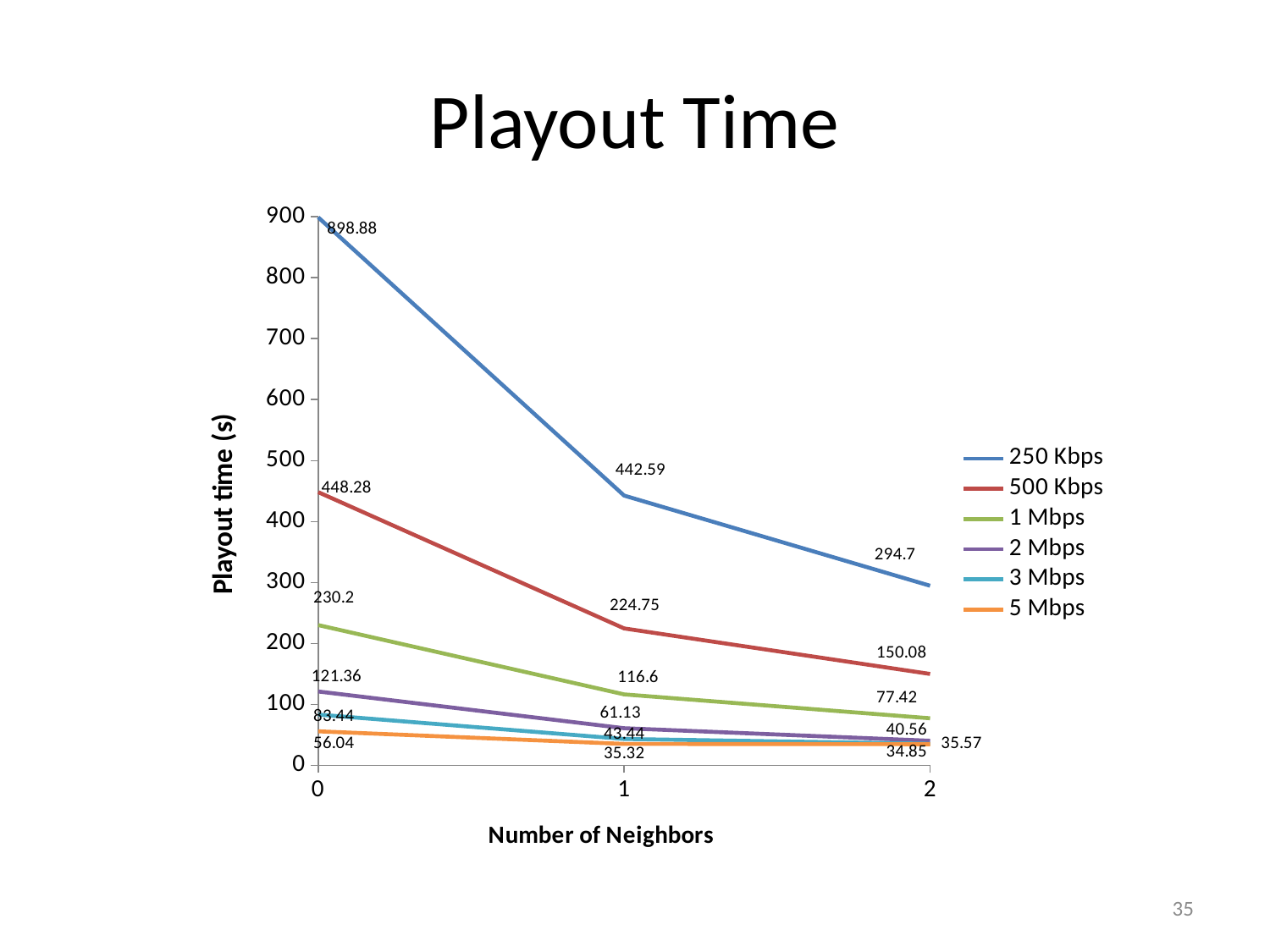
What is the playout time for 500 Kbps at 1 neighbor? 224.75 What is the playout time for 2 Mbps at 0 neighbors? 121.36 Does the playout time for 500 Kbps rise or fall as the number of neighbors increases? Fall Which is larger: the playout time for 500 Kbps at 2 neighbors or for 1 Mbps at 0 neighbors? 1 Mbps at 0 neighbors What is the playout time for 1 Mbps at 2 neighbors? 77.42 By how much does the playout time for 250 Kbps drop from 0 neighbors to 1 neighbor? 456.29 What is the playout time for 250 Kbps at 0 neighbors? 898.88 Which series has the highest playout time at 0 neighbors? 250 Kbps What kind of chart is shown on the slide? Line chart How many series does the legend list? 6 What is the title of the x axis? Number of Neighbors Which series has the lowest playout time at 0 neighbors? 5 Mbps